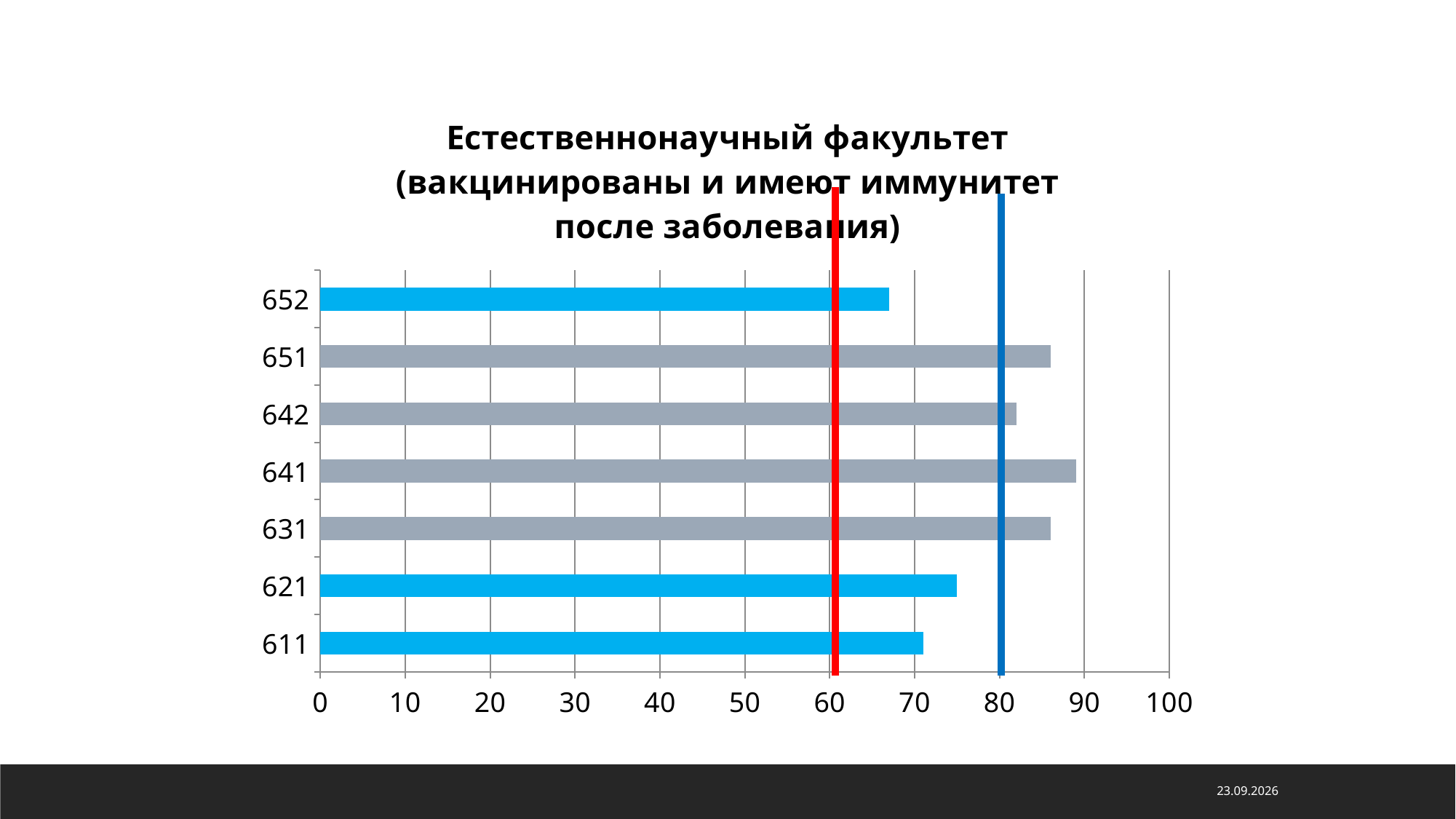
Which has the larger value, 652 or 651? 651 Which has the larger value, 621 or 611? 621 Is the value for 621 greater or less than 70? greater Is the value for 652 greater or less than 70? less What is the first line of the chart title? Естественнонаучный факультет Is the value for 611 greater or less than 80? less How many categories (groups) are plotted on the chart? 7 What kind of chart is shown on the slide? bar chart Which category has the shortest bar? 652 Which category has the longest bar? 641